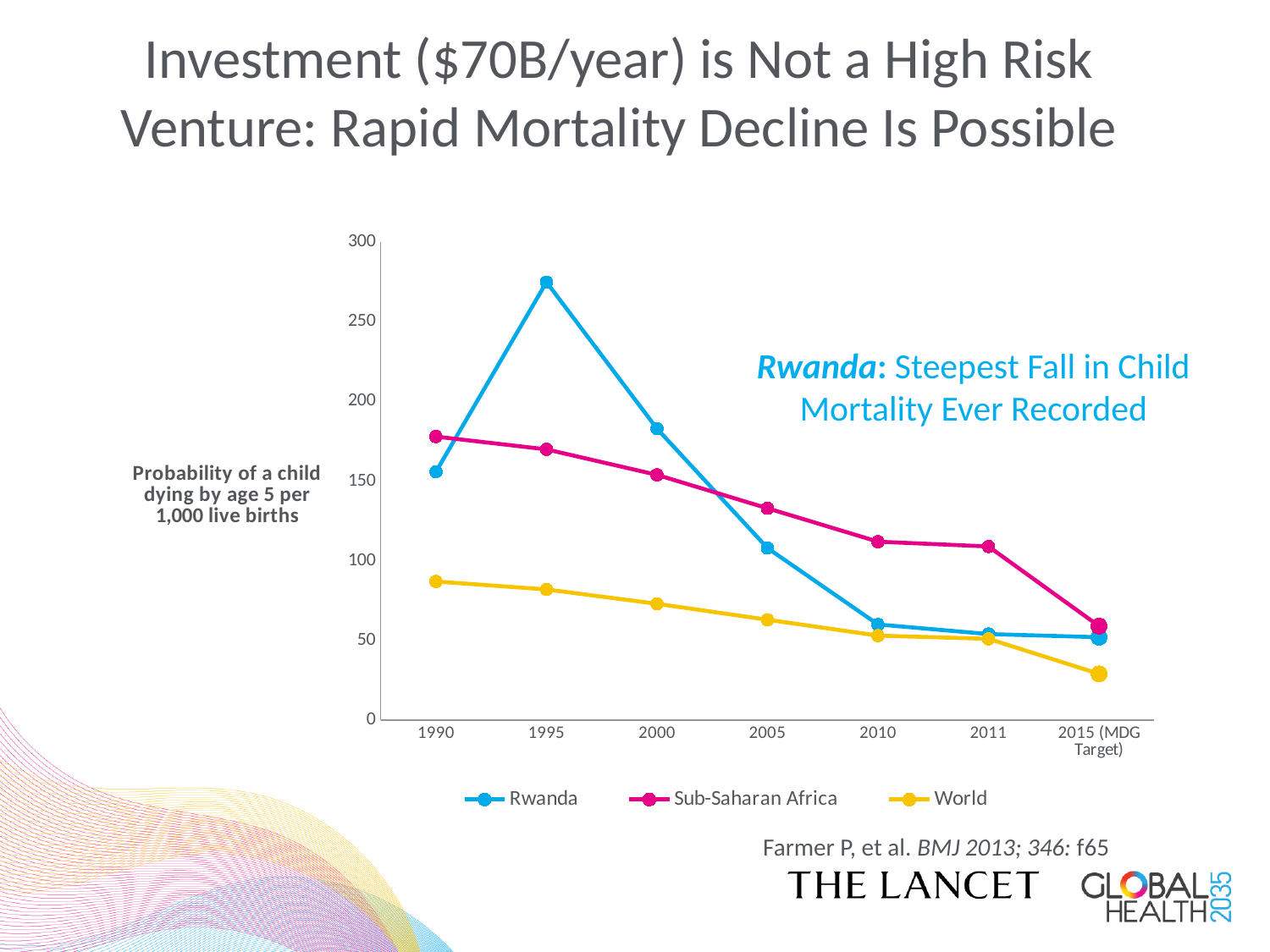
How many series does the legend list? 3 In which year does the Rwanda series reach its highest value? 1995 In 2005, which is higher: Rwanda or Sub-Saharan Africa? Sub-Saharan Africa How many points are shown along the x axis? 7 Is the value for World in 1990 greater or less than 100? less In 1990, which is higher: Rwanda or Sub-Saharan Africa? Sub-Saharan Africa What kind of chart is shown on the slide? Line chart Is the value for Sub-Saharan Africa in 2015 (MDG Target) greater or less than 100? less Is the value for Rwanda in 1995 greater or less than 250? greater Does the World series rise or fall from 1990 to 2015 (MDG Target)? Fall What is the label on the y axis of the chart? Probability of a child dying by age 5 per 1,000 live births